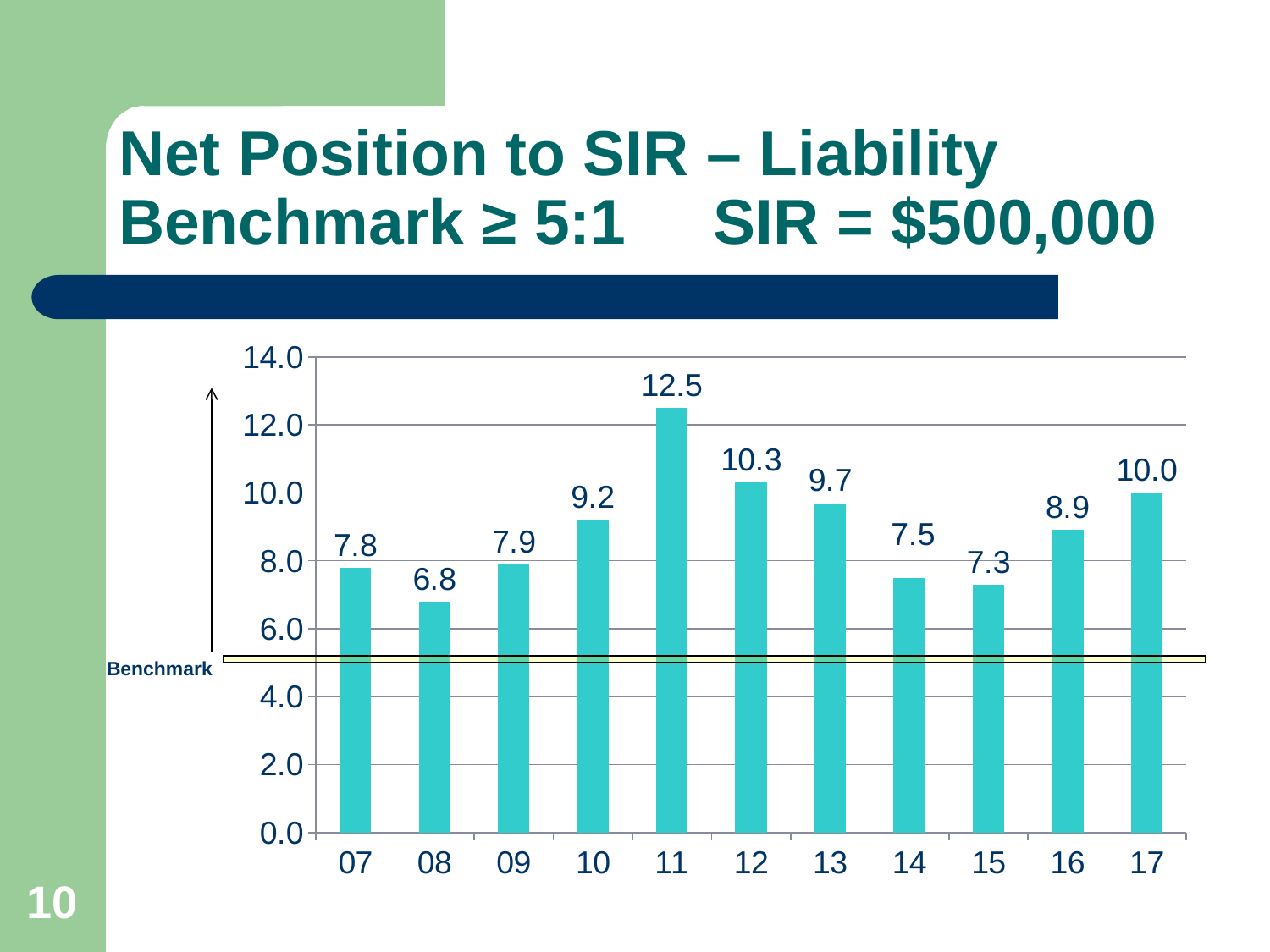
How many years are shown on the x axis? 11 What is the value for 17? 10.0 Is the value for 14 greater or less than 8.0? less Which is larger, the value for 13 or the value for 16? 13 What is the label on the horizontal line drawn across the chart? Benchmark Do the values rise or fall from 14 to 17? rise What is the value for 08? 6.8 Which year has the lowest value? 08 What is the difference between the values for 11 and 12? 2.2 Which year has the highest value? 11 What is the value for 11? 12.5 What kind of chart is this? bar chart